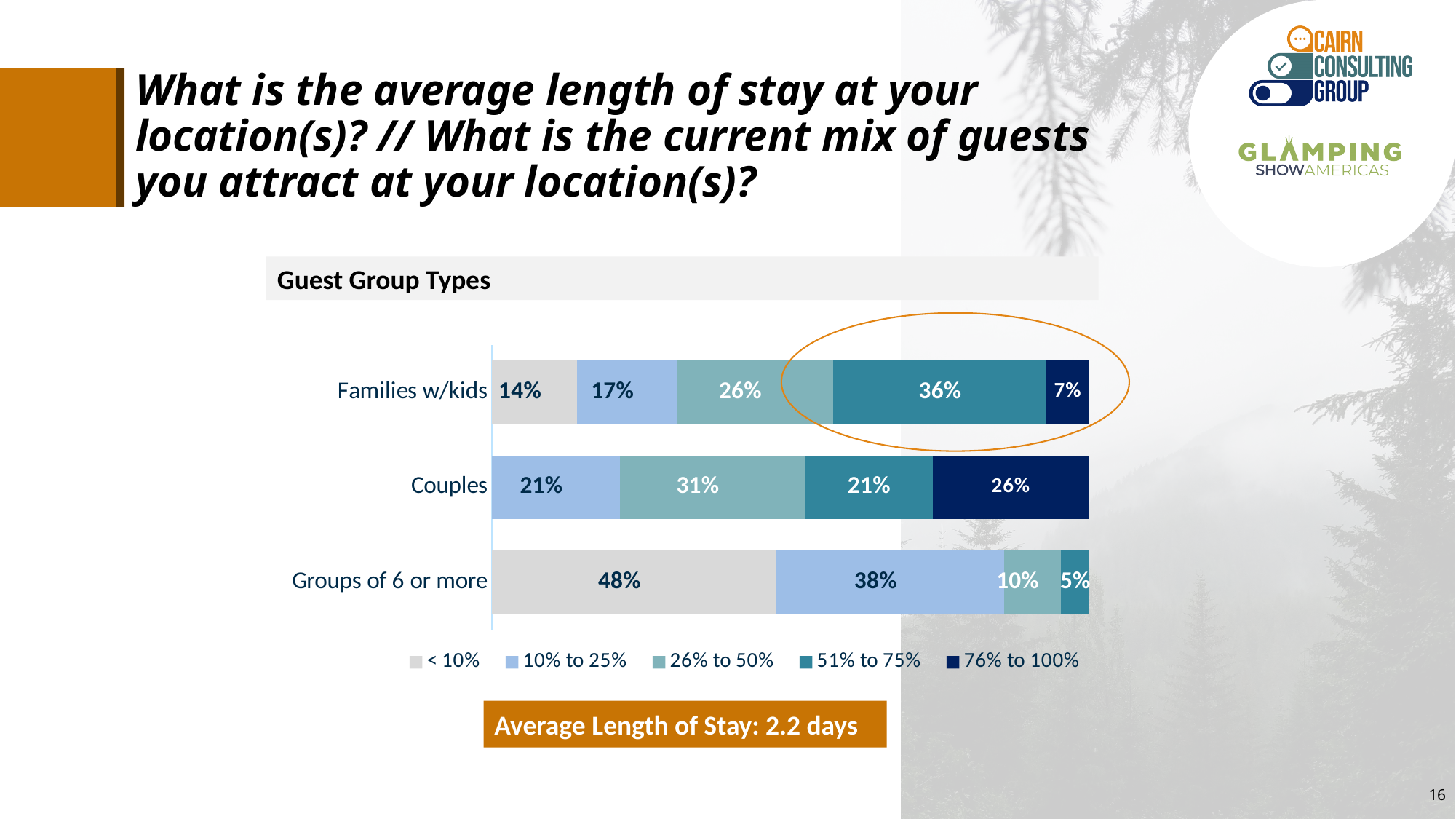
In the Guest Group Types chart, what is the value of the "< 10%" segment for Groups of 6 or more? 48% What kind of chart is shown under "Guest Group Types"? Stacked bar chart What average length of stay is stated on the slide? 2.2 days In the Guest Group Types chart, what is the difference between the "10% to 25%" segments for Groups of 6 or more and Families w/kids? 21% In the Guest Group Types chart, which is larger: the "51% to 75%" segment for Families w/kids or for Couples? Families w/kids In the Guest Group Types chart, which category has the smallest "76% to 100%" segment? Groups of 6 or more How many guest group categories are plotted in the Guest Group Types chart? 3 In the Guest Group Types chart, what is the value of the "51% to 75%" segment for Families w/kids? 36% In the Guest Group Types chart, which category has the largest "< 10%" segment? Groups of 6 or more In the Guest Group Types chart, what is the value of the "76% to 100%" segment for Couples? 26% How many series does the legend of the Guest Group Types chart list? 5 In the Guest Group Types chart, what is the value of the "26% to 50%" segment for Couples? 31%